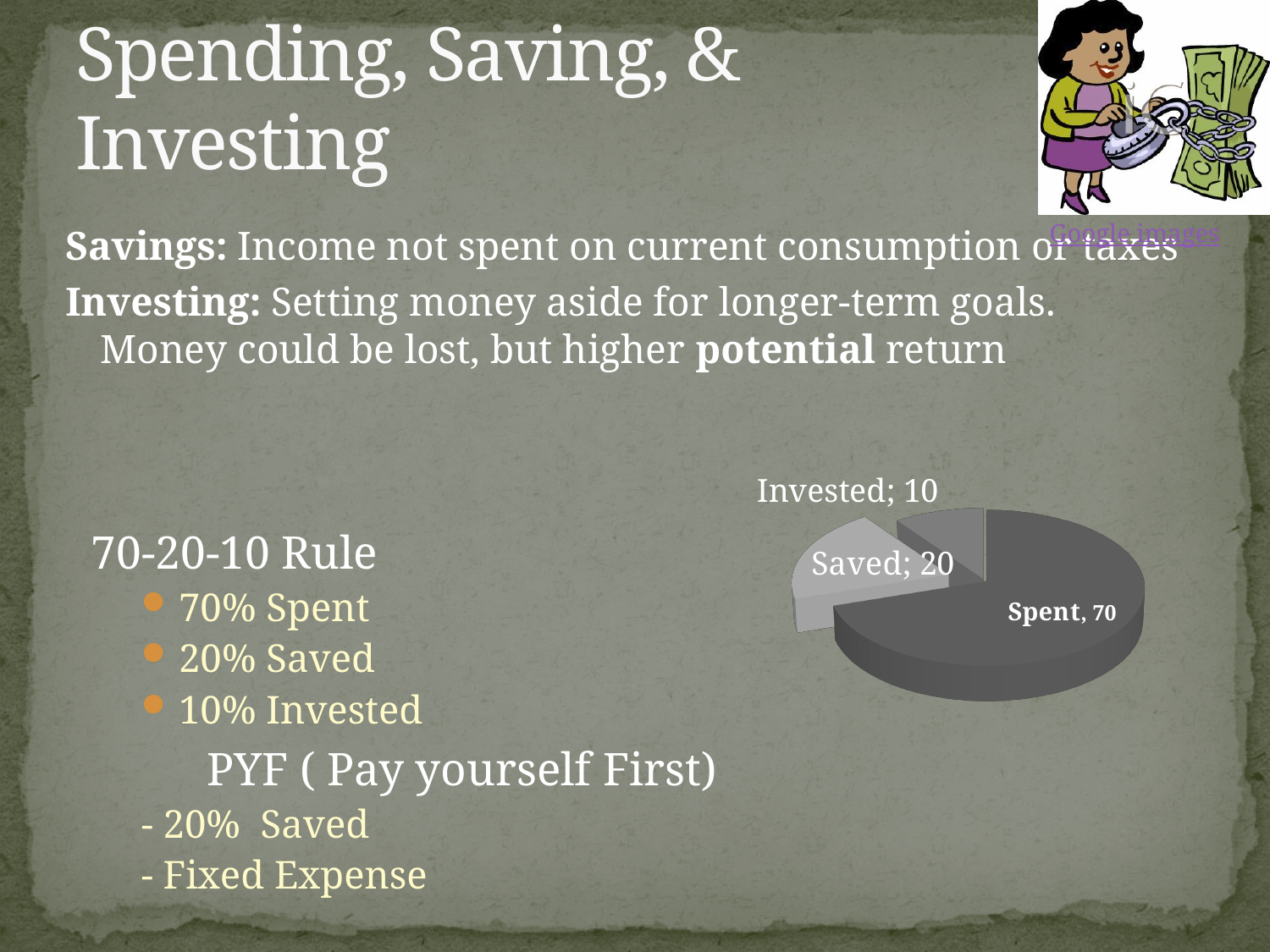
Which slice of the pie chart is the smallest? Invested What share of the pie chart does the Invested slice represent? 10% What is the difference between the Saved and Invested values in the pie chart? 10 What kind of chart is shown on the slide? pie chart What share of the pie chart does the Spent slice represent? 70% Which is larger in the pie chart, Saved or Invested? Saved What is the value for Invested in the pie chart? 10 Which slice of the pie chart is the largest? Spent What is the difference between the Spent and Saved values in the pie chart? 50 How many slices does the pie chart have? 3 What is the value for Saved in the pie chart? 20 What is the value for Spent in the pie chart? 70